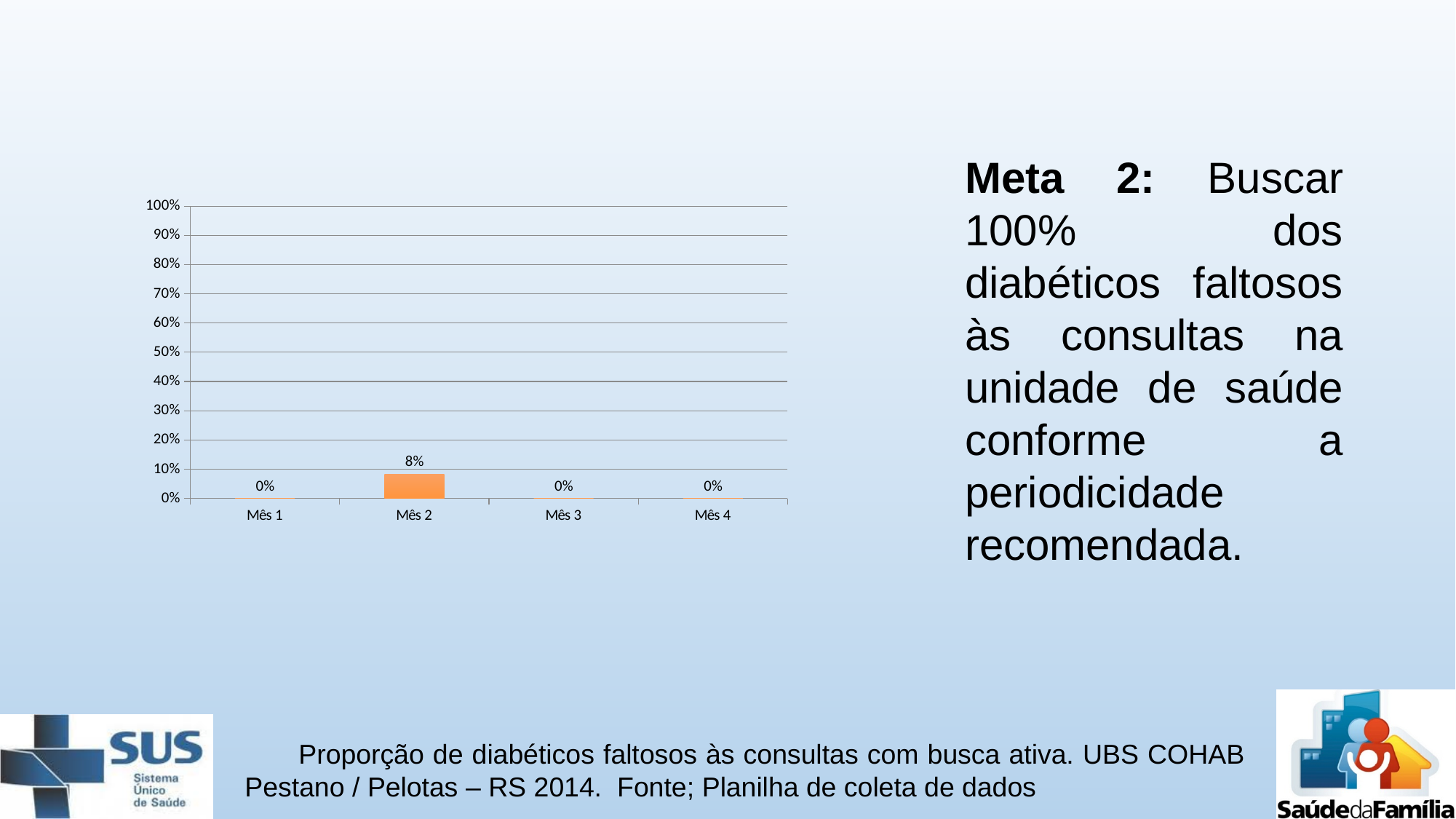
What is the difference between the values for Mês 2 and Mês 3? 8% Which is larger, the value for Mês 2 or the value for Mês 4? Mês 2 What is the value for Mês 1? 0% What is the highest value shown on the y axis? 100% What kind of chart is shown on the slide? bar chart How many months have a value of 0%? 3 Is the value for Mês 2 greater or less than 10%? less What is the value for Mês 2? 8% Which month has the highest value? Mês 2 How many months are shown on the x axis? 4 What colour are the bars in the chart? orange What is the value for Mês 4? 0%